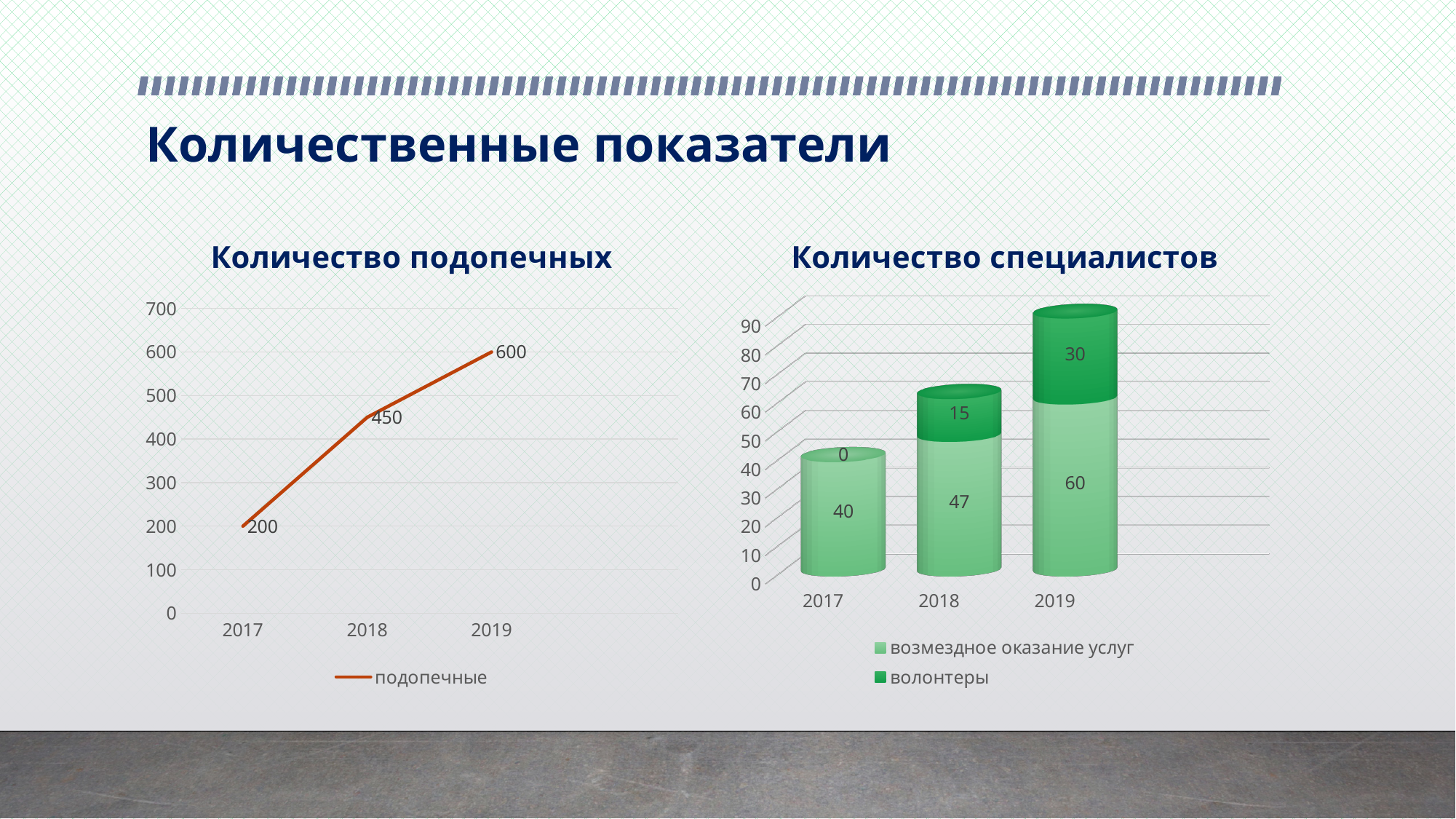
What kind of chart is the one titled "Количество специалистов"? bar chart How many series does the legend of the chart titled "Количество специалистов" list? 2 What kind of chart is the one titled "Количество подопечных"? line chart In the chart titled "Количество подопечных", what is the value for 2018? 450 In the chart titled "Количество подопечных", what is the value for 2019? 600 In the chart titled "Количество специалистов", what is the value for "возмездное оказание услуг" in 2019? 60 In the chart titled "Количество специалистов", what is the total of the stacked bar for 2018? 62 In the chart titled "Количество подопечных", do the values rise or fall from 2017 to 2019? rise In the chart titled "Количество специалистов", what is the value for "волонтеры" in 2018? 15 In the chart titled "Количество специалистов", which year has the lowest value for "возмездное оказание услуг"? 2017 In the chart titled "Количество специалистов", what is the total of the stacked bar for 2019? 90 In the chart titled "Количество подопечных", what is the difference between the 2019 and 2017 values? 400